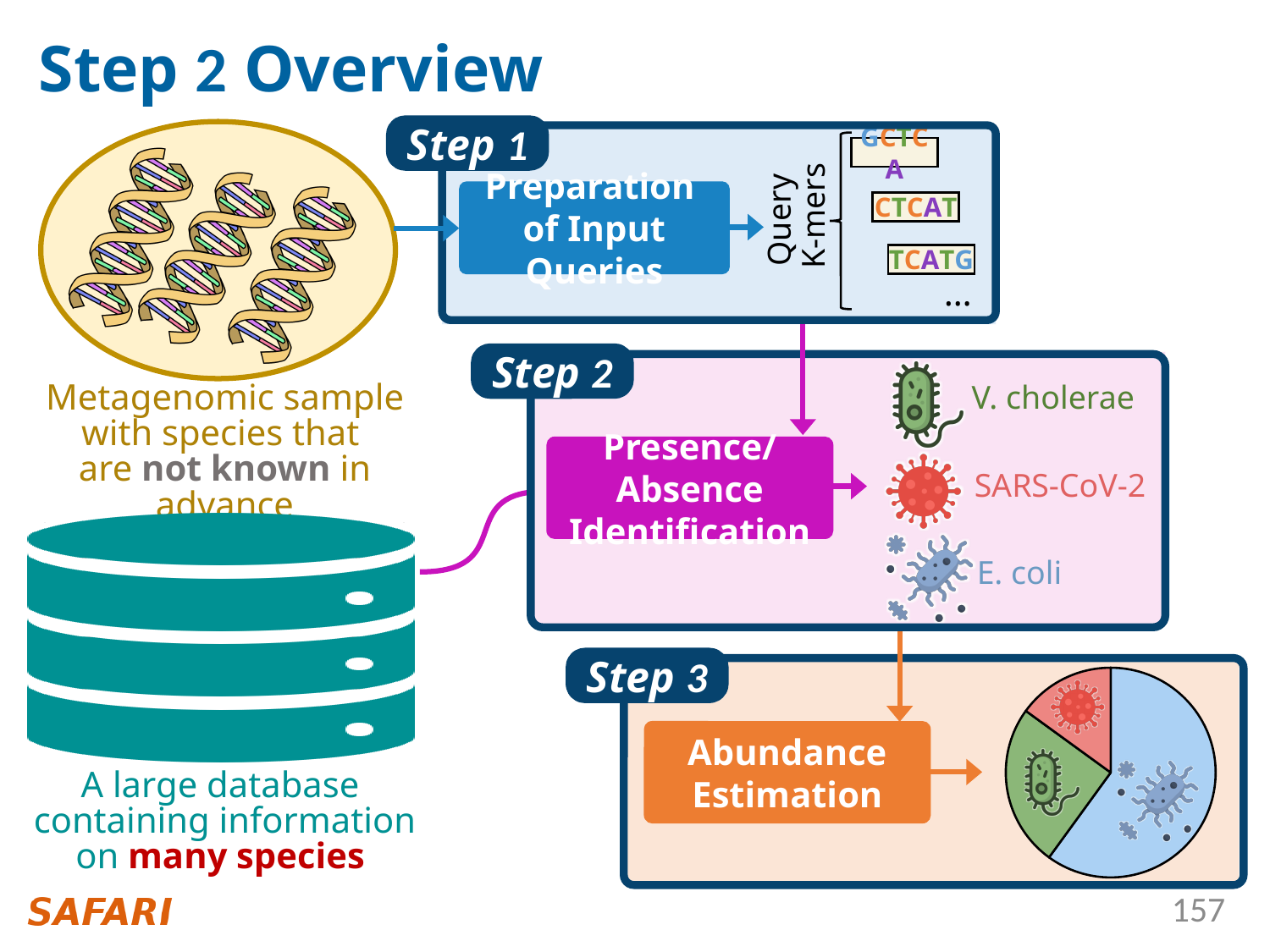
Does the pie chart in the Step 3 box show any numeric data labels? No In the pie chart in the Step 3 box, is the blue slice larger or smaller than the green slice? larger How many slices does the pie chart in the Step 3 box have? 3 What colours are the three slices of the pie chart in the Step 3 box? red, green and blue What kind of chart is shown in the Step 3 box? pie chart In the pie chart in the Step 3 box, which colour slice is the largest? blue In the pie chart in the Step 3 box, is the blue slice larger or smaller than the red slice? larger